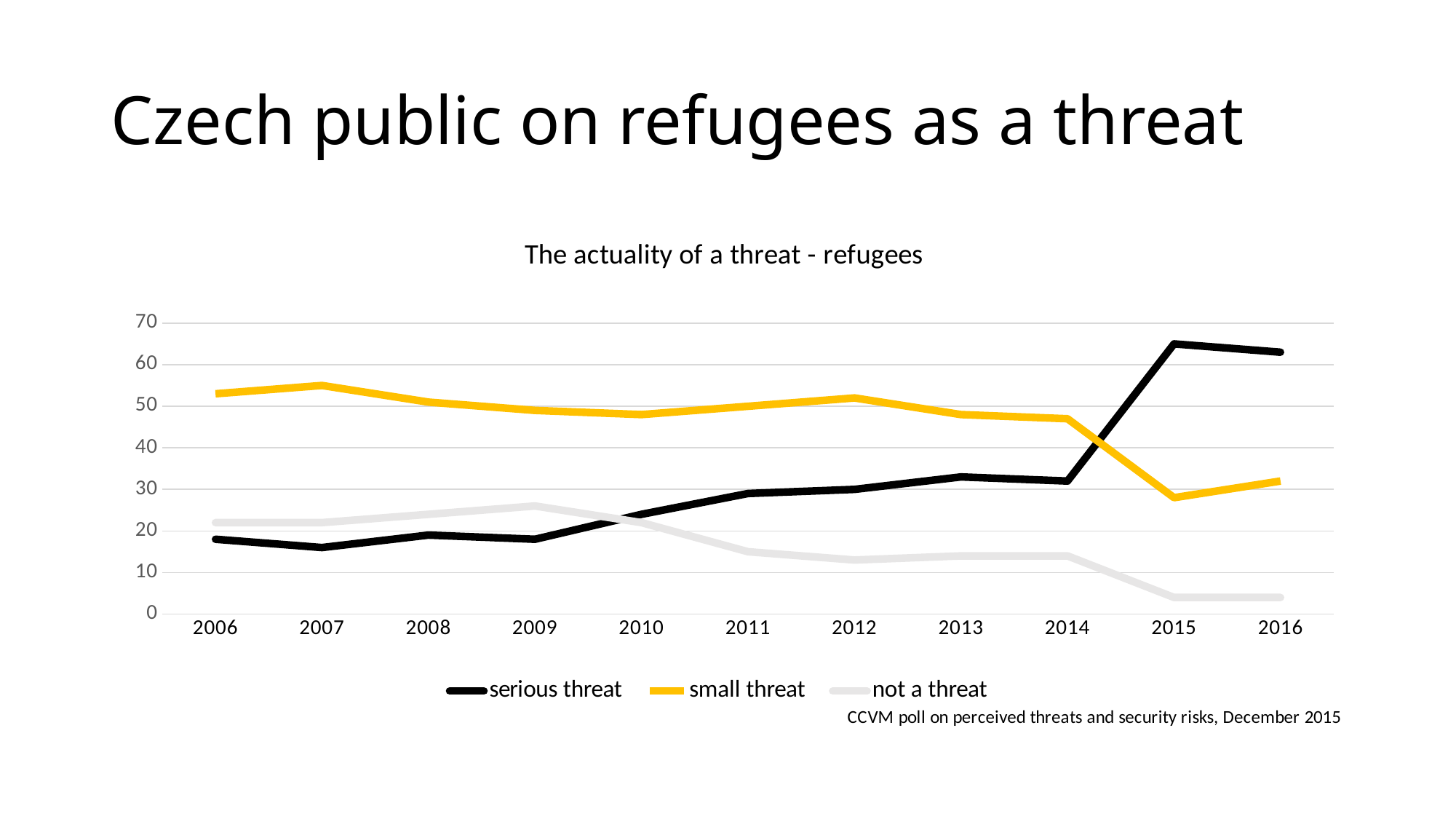
How many years are shown on the x axis? 11 In which year is the 'small threat' series at its lowest? 2015 In which year is the 'serious threat' series at its highest? 2015 In 2014, which series has the larger value: 'small threat' or 'serious threat'? small threat Is the value for 'not a threat' in 2016 greater or less than 10? less Does the 'not a threat' series rise or fall from 2010 to 2016? fall In 2016, which series has the larger value: 'serious threat' or 'small threat'? serious threat Is the value for 'serious threat' in 2015 greater or less than 60? greater Is the value for 'small threat' in 2007 greater or less than 50? greater What is the title of the chart? The actuality of a threat - refugees What kind of chart is shown on the slide? line chart How many series does the legend list? 3